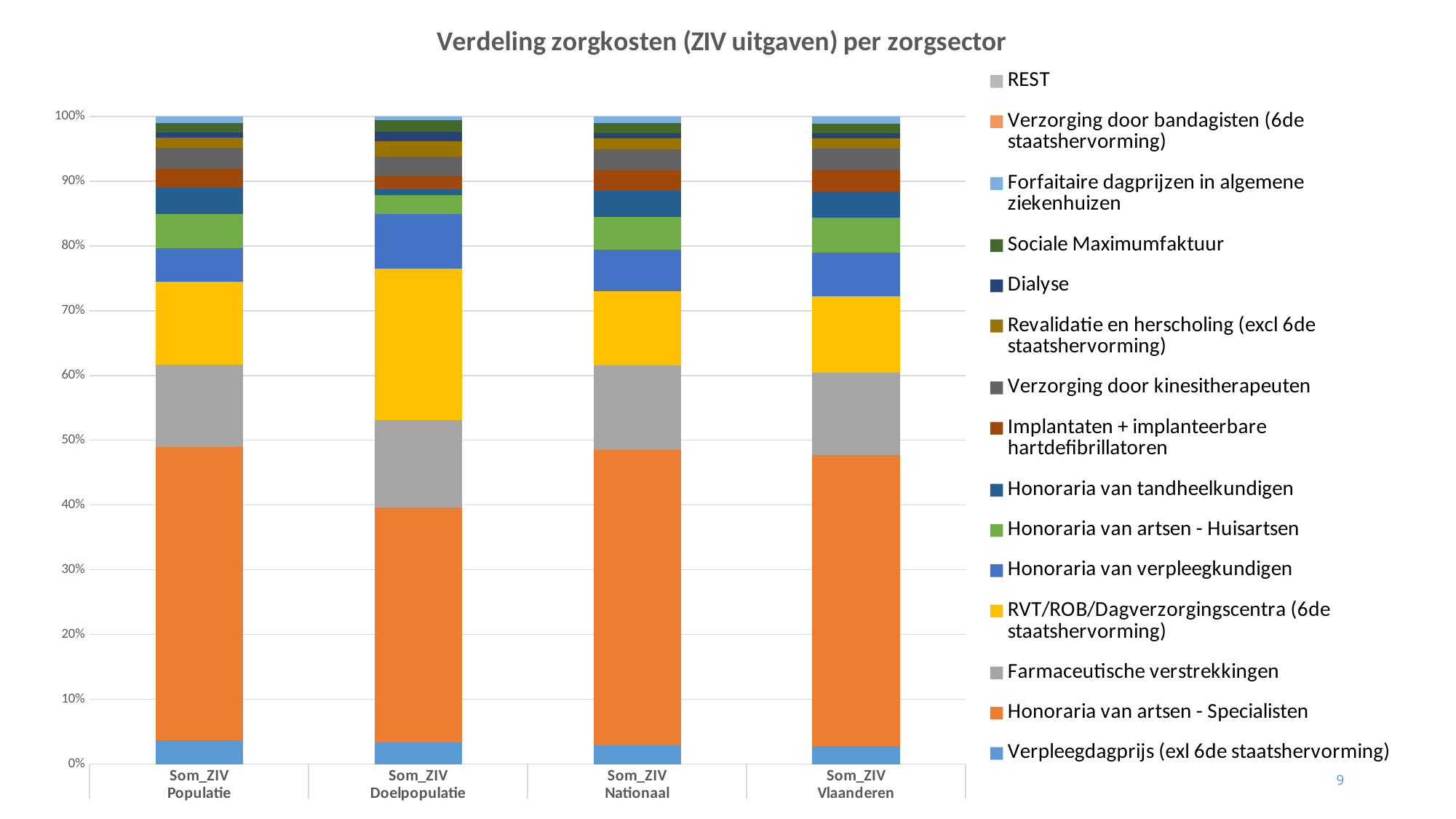
What is the title of the chart? Verdeling zorgkosten (ZIV uitgaven) per zorgsector Is the Honoraria van artsen - Specialisten segment larger for Som_ZIV Populatie or for Som_ZIV Doelpopulatie? Som_ZIV Populatie Is the Honoraria van verpleegkundigen segment larger for Som_ZIV Doelpopulatie or for Som_ZIV Nationaal? Som_ZIV Doelpopulatie Which series is plotted at the bottom of each stacked bar? Verpleegdagprijs (exl 6de staatshervorming) How many bars (categories) are plotted on the x axis? 4 How many series does the legend list? 15 Which series forms the largest segment in every bar? Honoraria van artsen - Specialisten What is the total height of each stacked bar? 100% Which category has the largest RVT/ROB/Dagverzorgingscentra (6de staatshervorming) segment? Som_ZIV Doelpopulatie Is the Verpleegdagprijs (exl 6de staatshervorming) segment for Som_ZIV Vlaanderen greater or less than 10%? less What kind of chart is shown on the slide? Stacked bar chart Is the Honoraria van artsen - Specialisten segment for Som_ZIV Populatie greater or less than 40%? greater